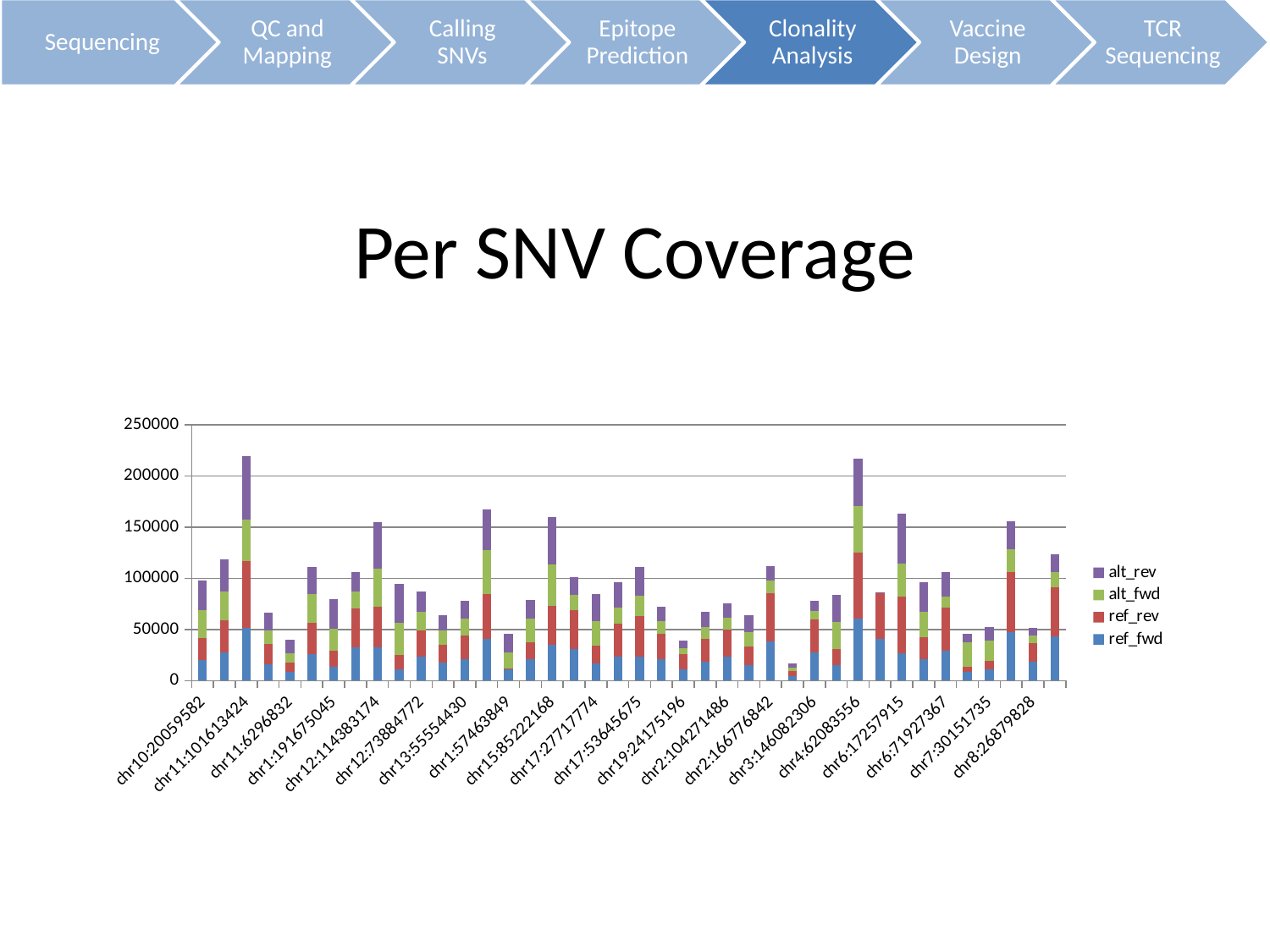
Is the total value for chr4:62083556 greater or less than 200000? greater What kind of chart is shown on the slide? Stacked bar chart How many series does the legend list? 4 Is the total value for chr11:101613424 greater or less than 200000? greater Is the total value for chr12:114383174 greater or less than 100000? greater Which series is shown at the bottom of each stacked bar? ref_fwd Which has the larger total, chr11:101613424 or chr11:6296832? chr11:101613424 Which has the larger total, chr6:17257915 or chr7:30151735? chr6:17257915 What is the title of the chart? Per SNV Coverage